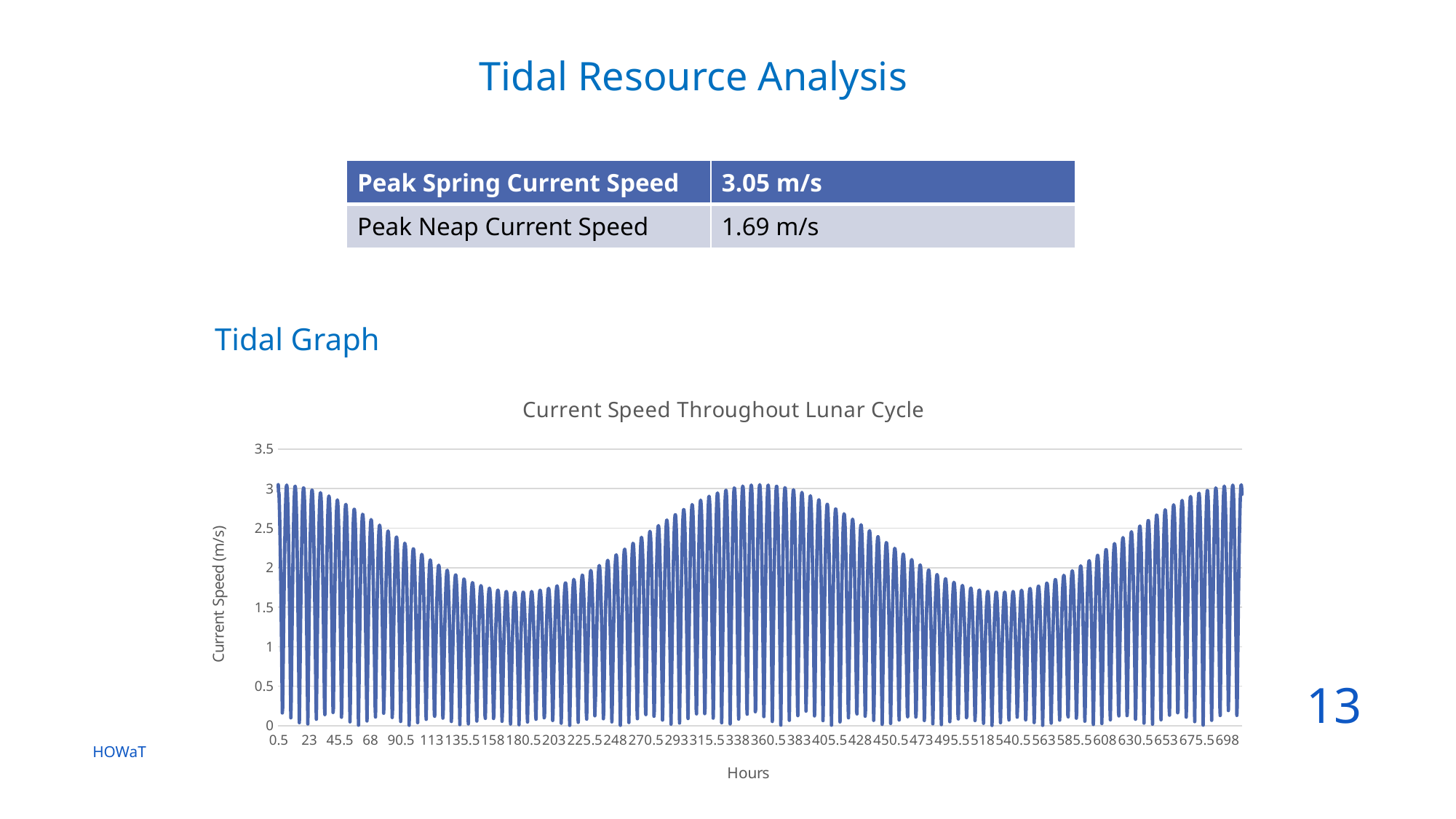
Is the highest current speed plotted on the chart greater or less than 2.5? greater Do the peak current speeds on the chart rise or fall between hour 0.5 and hour 180.5? fall Do the peak current speeds on the chart rise or fall between hour 540.5 and hour 698? rise Is the peak current speed around hour 360.5 greater or less than 2.5? greater Is the lowest current speed plotted on the chart greater or less than 0.5? less What kind of chart is shown under the heading Tidal Graph? line chart What is the label of the vertical axis of the chart? Current Speed (m/s) Which has the higher peak current speed on the chart: the cycle around hour 360.5 or the cycle around hour 540.5? around hour 360.5 What is the title of the chart on the slide? Current Speed Throughout Lunar Cycle What is the highest value shown on the vertical axis of the chart? 3.5